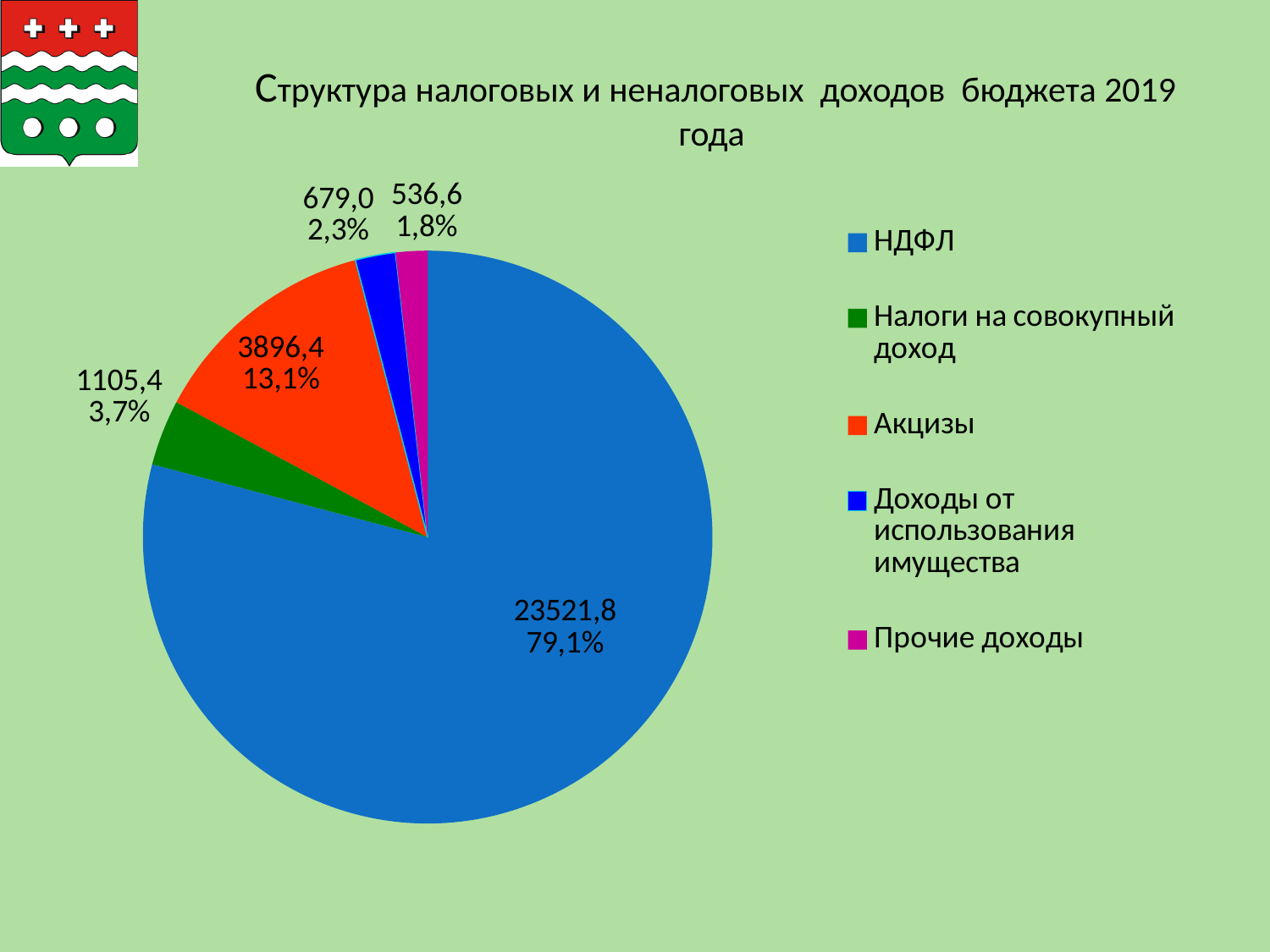
What is the value shown for Прочие доходы? 536,6 What is the difference between the values for Акцизы and Налоги на совокупный доход? 2791,0 What share of the pie does НДФЛ take? 79,1% What share of the pie does Акцизы take? 13,1% Which category has the largest slice? НДФЛ What kind of chart is shown on the slide? pie chart How many categories does the pie chart have? 5 What is the value shown for НДФЛ? 23521,8 Which category has the smallest slice? Прочие доходы What share of the pie does Доходы от использования имущества take? 2,3% What is the value shown for Акцизы? 3896,4 What is the value shown for Налоги на совокупный доход? 1105,4